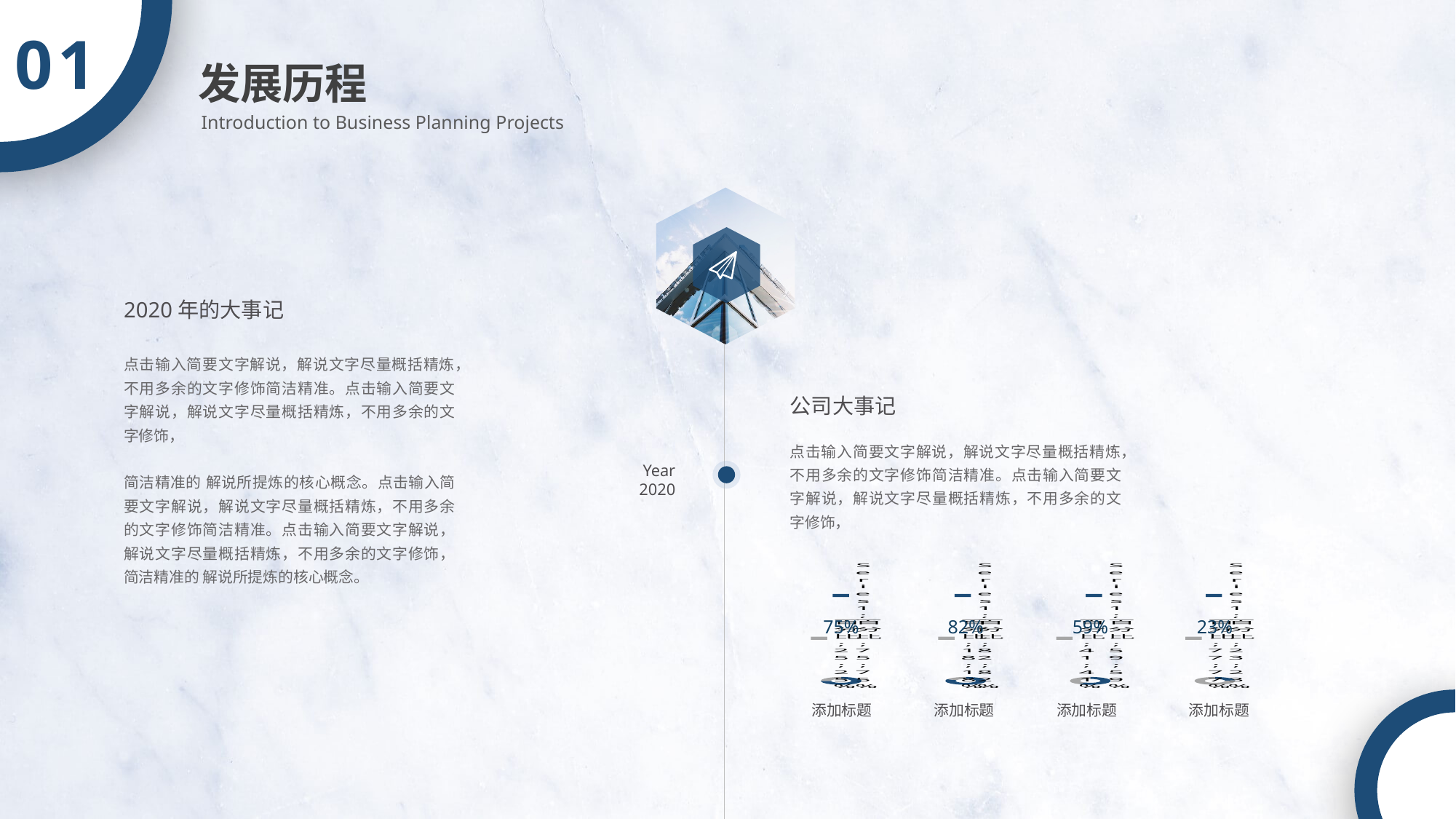
What percentage is shown on the third small chart from the left under 公司大事记? 59% What percentage is shown on the rightmost of the four small charts under 公司大事记? 23% Which of the four small charts shows the lowest percentage, by position from the left? the fourth chart (23%) Which of the four small charts shows the highest percentage, by position from the left? the second chart (82%) How many small charts are shown under 公司大事记? 4 Is the percentage on the leftmost small chart larger or smaller than the one on the third small chart? larger What percentage is shown on the second small chart from the left under 公司大事记? 82% What percentage is shown on the leftmost of the four small charts under 公司大事记? 75% What caption appears below each of the four small charts? 添加标题 What is the difference between the percentages shown on the second and fourth small charts? 59%